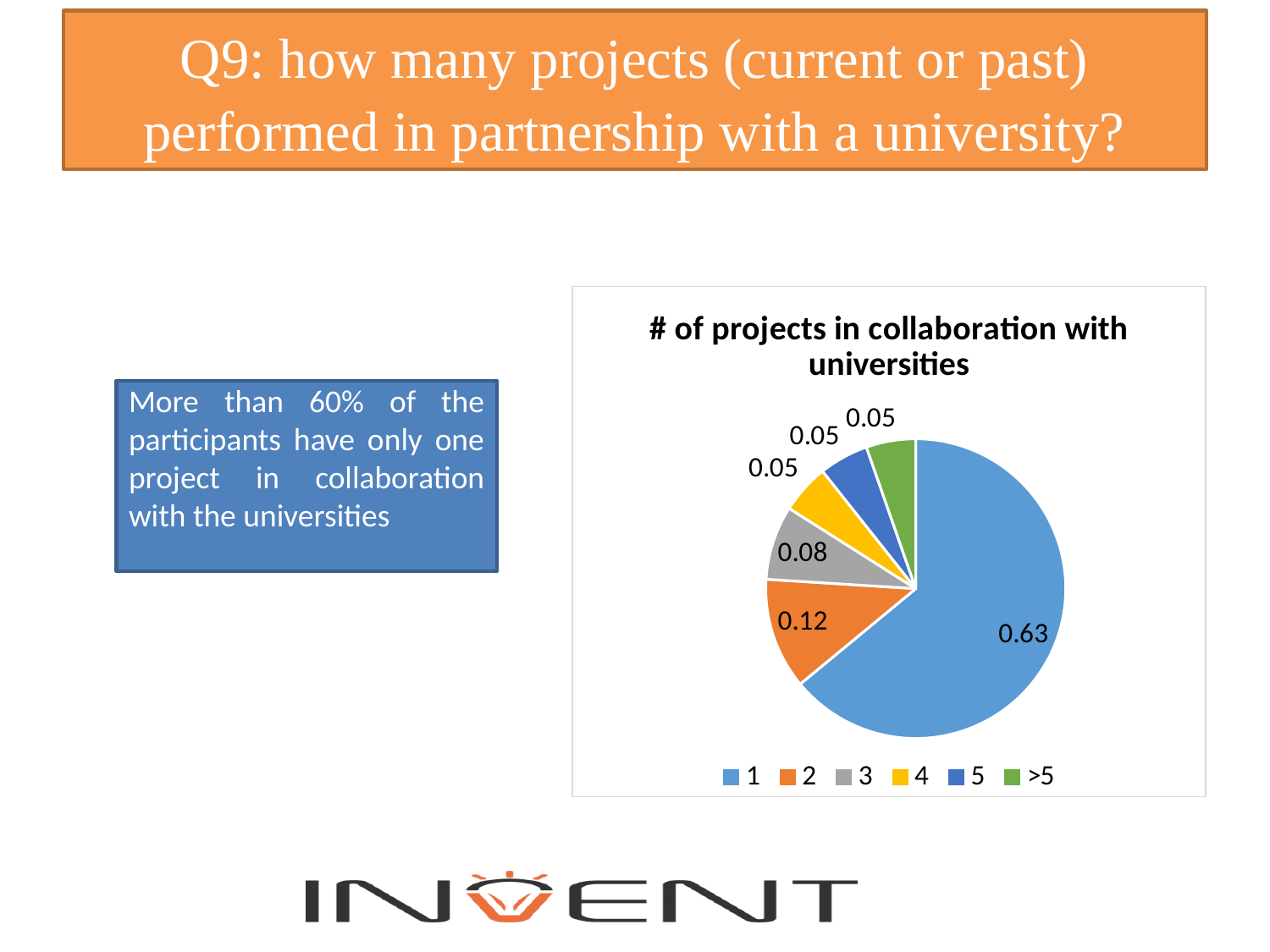
What is the difference between the values for category 3 and category 4? 0.03 How many categories does the legend of the pie chart list? 6 What is the value for category >5 in the pie chart? 0.05 What is the difference between the values for category 1 and category 2? 0.51 What is the value for category 3 in the pie chart? 0.08 Which is larger, the value for category 2 or the value for category 3? 2 What is the value for category 2 in the pie chart? 0.12 What is the value for category 1 in the pie chart? 0.63 What is the title of the chart? # of projects in collaboration with universities What type of chart is shown on the slide? pie chart Which colour represents category 1 in the pie chart? blue Which category has the largest slice of the pie chart? 1